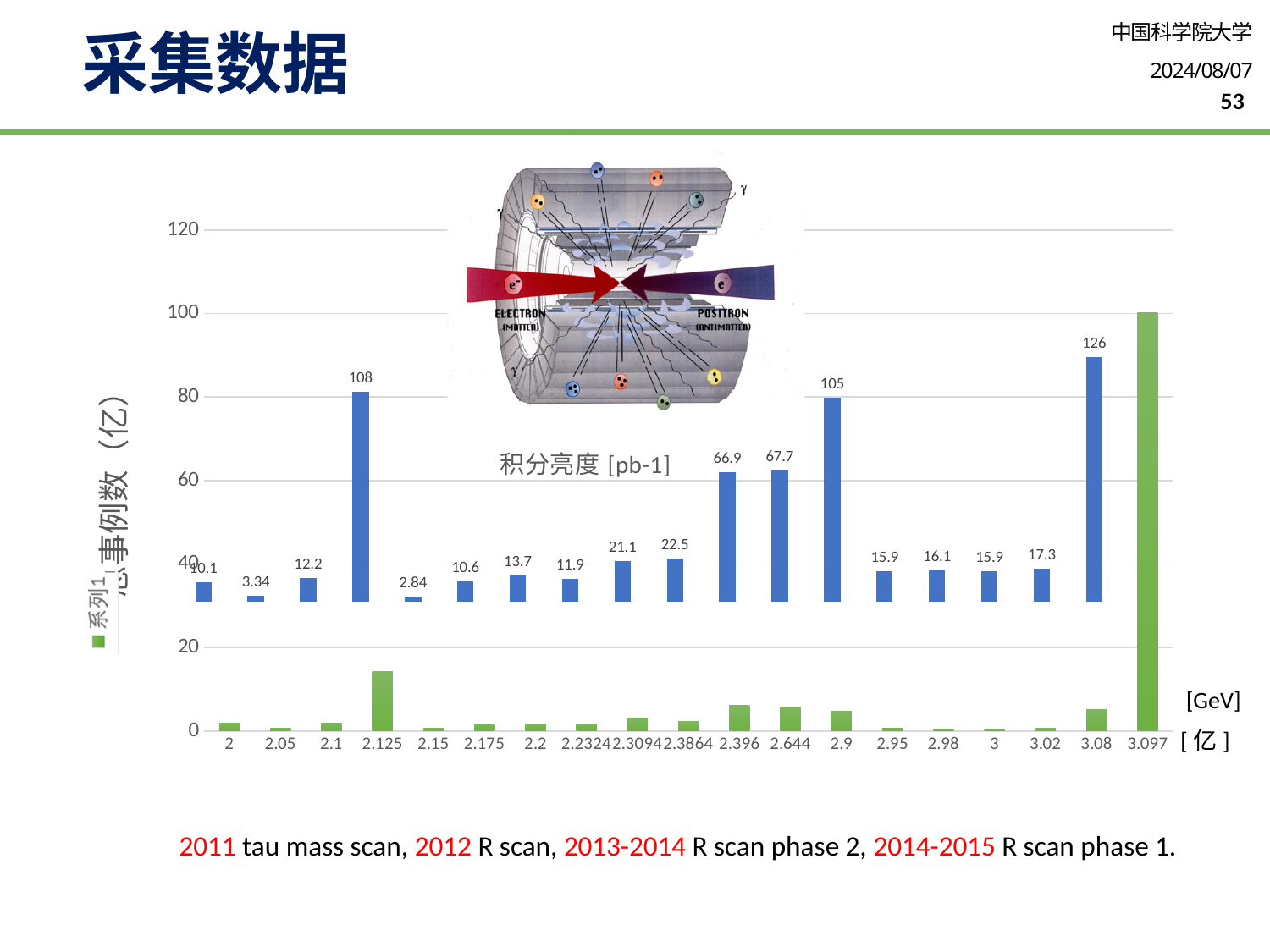
Which energy point has the lowest labelled integrated luminosity (积分亮度)? 2.15 In the green total-events (总事例数) series, is the value for 3.097 GeV greater or less than 80? greater What is the difference between the integrated luminosity labels at 3.08 GeV and 2.125 GeV? 18 In the green total-events (总事例数) series, is the value for 2.125 GeV greater or less than 20? less What is the integrated luminosity (积分亮度) value labelled for the 2.396 GeV energy point? 66.9 How many energy points are listed along the x axis of the chart? 19 What is the integrated luminosity (积分亮度) value labelled for the 2.05 GeV energy point? 3.34 What kind of chart is shown on the slide? bar chart Which energy point has the highest labelled integrated luminosity (积分亮度)? 3.08 What is the integrated luminosity (积分亮度) value labelled for the 2.9 GeV energy point? 105 Which has the larger labelled integrated luminosity, the 2.125 GeV point or the 2.9 GeV point? 2.125 What is the integrated luminosity (积分亮度) value labelled for the 2.125 GeV energy point? 108